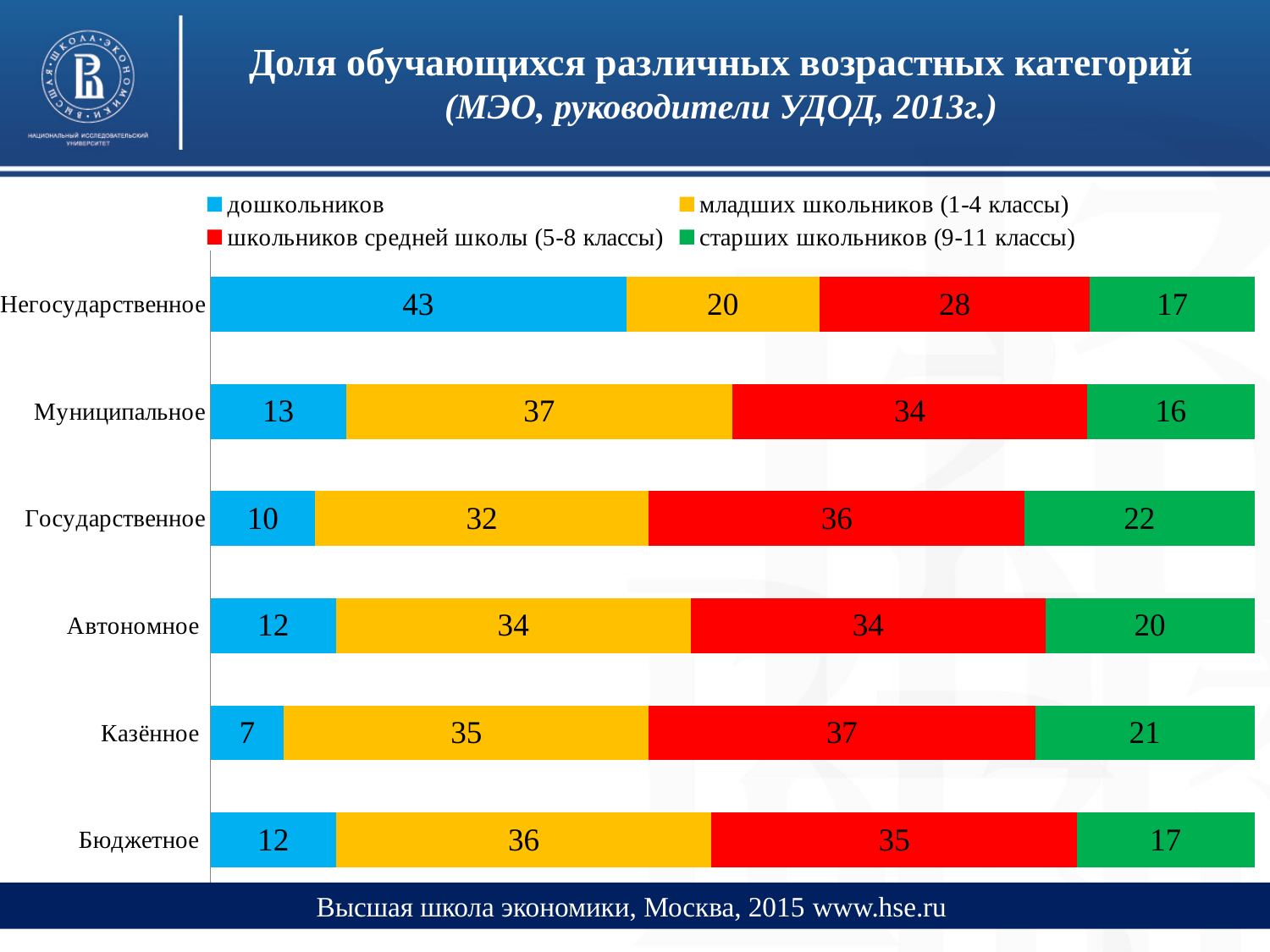
Which is larger: the value for школьников средней школы (5-8 классы) in Казённое or in Бюджетное? Казённое What kind of chart is shown on the slide? Stacked bar chart What is the value for дошкольников in the Негосударственное category? 43 What is the value for младших школьников (1-4 классы) in the Автономное category? 34 What is the value for старших школьников (9-11 классы) in the Государственное category? 22 Which category has the highest value for дошкольников? Негосударственное In the Муниципальное category, what is the difference between the value for младших школьников (1-4 классы) and the value for дошкольников? 24 Which category has the lowest value for дошкольников? Казённое How many categories are shown on the chart? 6 What colour represents старших школьников (9-11 классы) in the chart? Green How many series does the legend list? 4 What is the total of the stacked bar for Муниципальное? 100